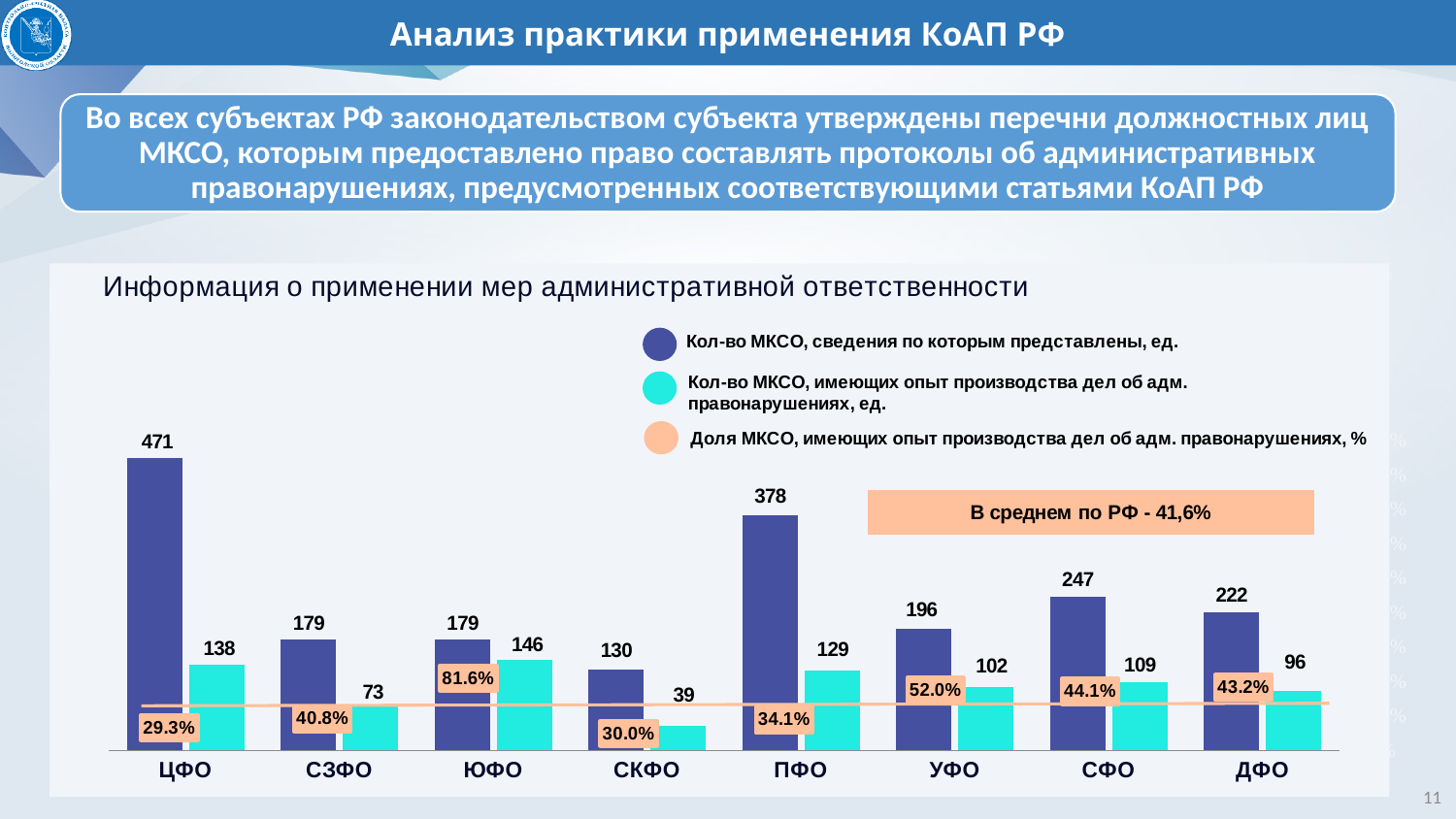
What is the share (Доля МКСО, имеющих опыт производства дел об адм. правонарушениях, %) for СКФО? 30.0% How many series does the legend list? 3 What kind of chart is shown on the slide? combination bar and line chart What is the difference between the values for ПФО and УФО in the series "Кол-во МКСО, сведения по которым представлены, ед."? 182 What is the average share for the Russian Federation stated on the chart (В среднем по РФ)? 41,6% Which is larger: the value for СФО or for ДФО in the series "Кол-во МКСО, имеющих опыт производства дел об адм. правонарушениях, ед."? СФО Which category has the highest value in the series "Кол-во МКСО, сведения по которым представлены, ед."? ЦФО Which category has the highest share (Доля МКСО, имеющих опыт производства дел об адм. правонарушениях, %)? ЮФО What is the value for ЦФО in the series "Кол-во МКСО, сведения по которым представлены, ед."? 471 Which category has the lowest value in the series "Кол-во МКСО, имеющих опыт производства дел об адм. правонарушениях, ед."? СКФО How many categories (federal districts) are shown on the x axis? 8 What is the value for ЮФО in the series "Кол-во МКСО, имеющих опыт производства дел об адм. правонарушениях, ед."? 146